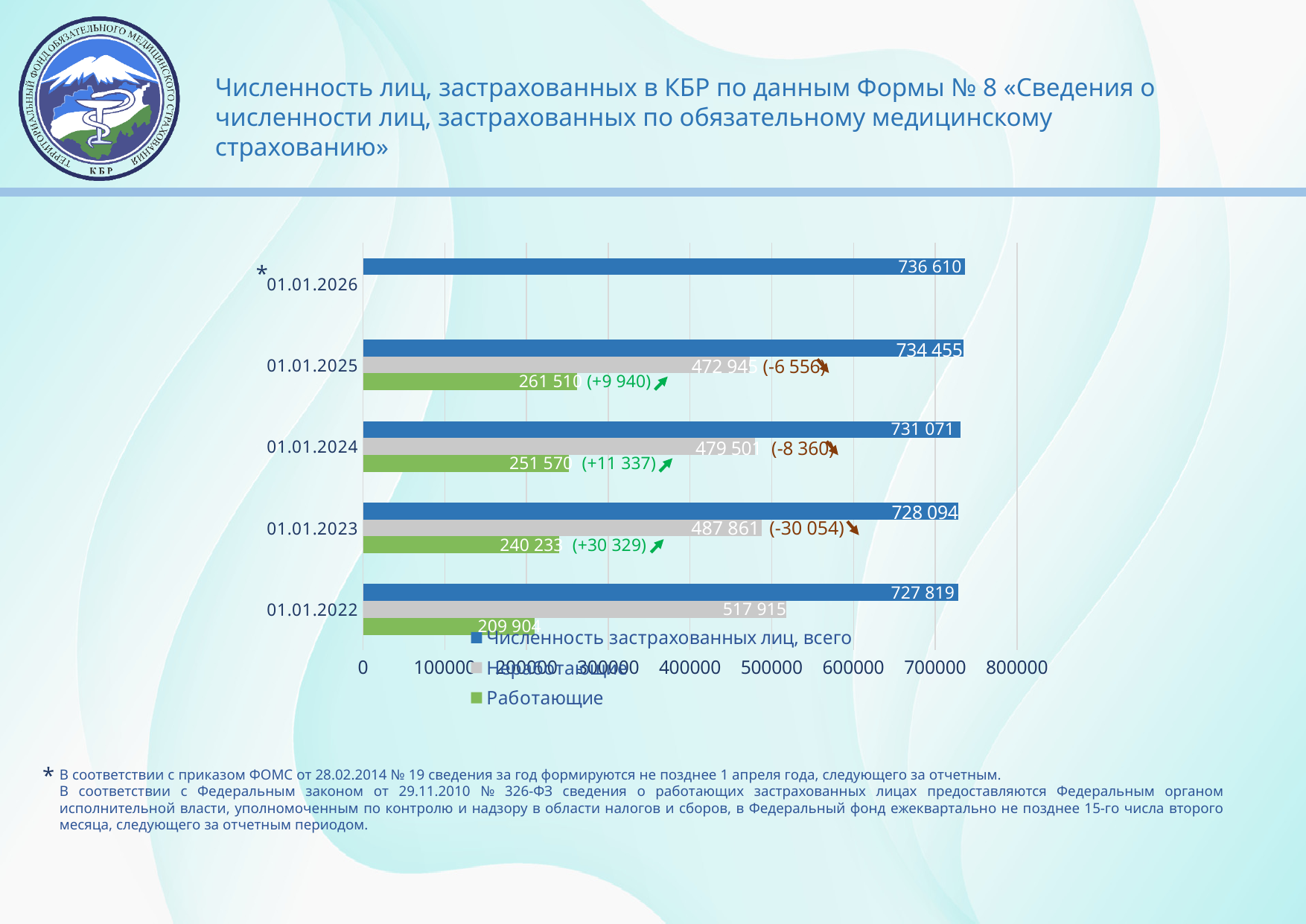
What is the difference between the Работающие values on 01.01.2025 and 01.01.2024? 9 940 What is the total number of insured persons (Численность застрахованных лиц, всего) on 01.01.2026? 736 610 What is the difference between the total number of insured persons on 01.01.2026 and 01.01.2025? 2 155 Does the value for Неработающие rise or fall from 01.01.2022 to 01.01.2025? Fall What is the value for Неработающие (non-working) on 01.01.2022? 517 915 Which date has the lowest value for Работающие (working)? 01.01.2022 What is the value for Работающие (working) on 01.01.2024? 251 570 What kind of chart is shown on the slide? Bar chart How many series does the legend list? 3 Which date has the highest total number of insured persons? 01.01.2026 Which is larger on 01.01.2023: the Неработающие value or the Работающие value? Неработающие How many dates (categories) are shown on the chart? 5